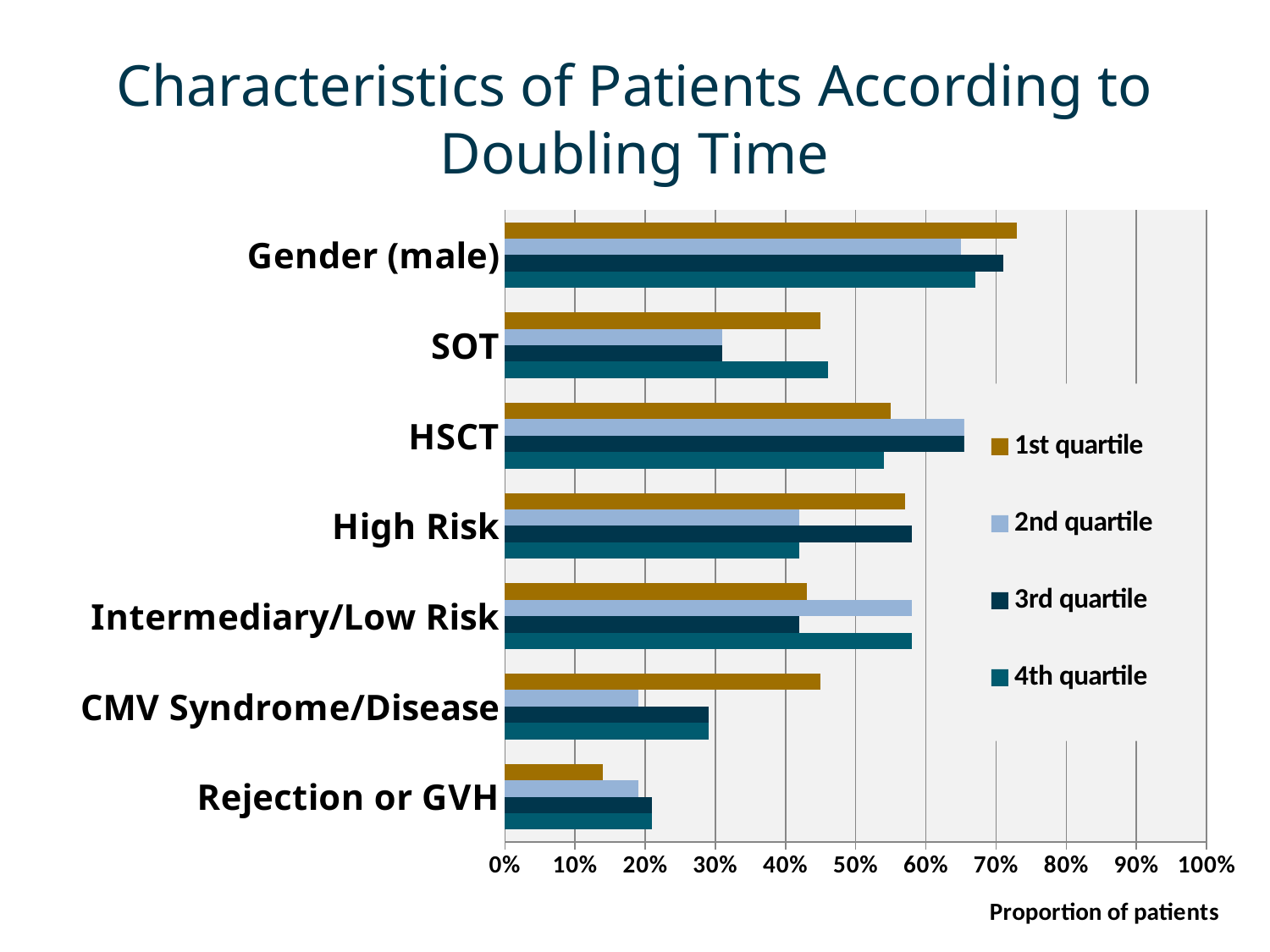
How many patient characteristic categories are listed on the vertical axis? 7 For CMV Syndrome/Disease, which is larger: the 1st quartile value or the 2nd quartile value? 1st quartile Is the 1st quartile value for CMV Syndrome/Disease greater or less than 40%? greater Is the 1st quartile value for Rejection or GVH greater or less than 20%? less Which category has the highest 1st quartile value? Gender (male) Is the 1st quartile value for Gender (male) greater or less than 70%? greater What is the title of the horizontal axis? Proportion of patients For HSCT, which is larger: the 1st quartile value or the 2nd quartile value? 2nd quartile What kind of chart is shown on the slide? bar chart Which category has the lowest 1st quartile value? Rejection or GVH How many series does the legend list? 4